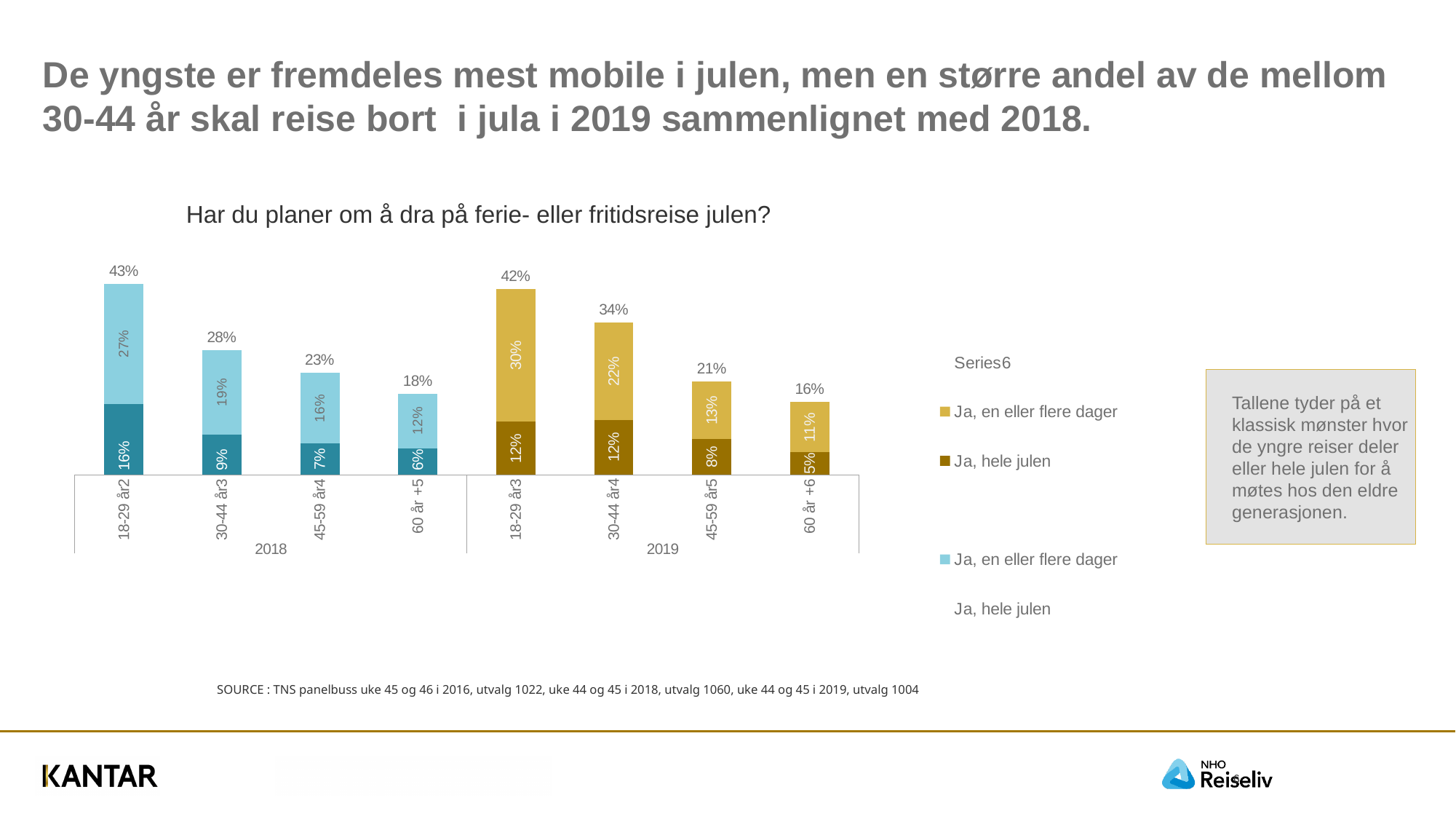
What is the total value shown above the bar for 18-29 år in 2018? 43% What kind of chart is shown on the slide? Stacked bar chart What is the difference between the total for 30-44 år in 2019 (34%) and in 2018 (28%)? 6 percentage points Which is larger: the total for 18-29 år in 2018 or the total for 18-29 år in 2019? 18-29 år in 2018 (43%) What is the value of the 'Ja, en eller flere dager' segment for 45-59 år in 2018? 16% What is the value of the 'Ja, hele julen' segment for 18-29 år in 2019? 12% What is the total value shown above the bar for 30-44 år in 2019? 34% What is the title of the chart? Har du planer om å dra på ferie- eller fritidsreise julen? Do the total values fall as the age groups get older within 2019? Yes, they fall How many bars are plotted in the chart in total? 8 Which age group has the highest total bar in 2019? 18-29 år Which age group has the lowest total bar in 2018? 60 år +